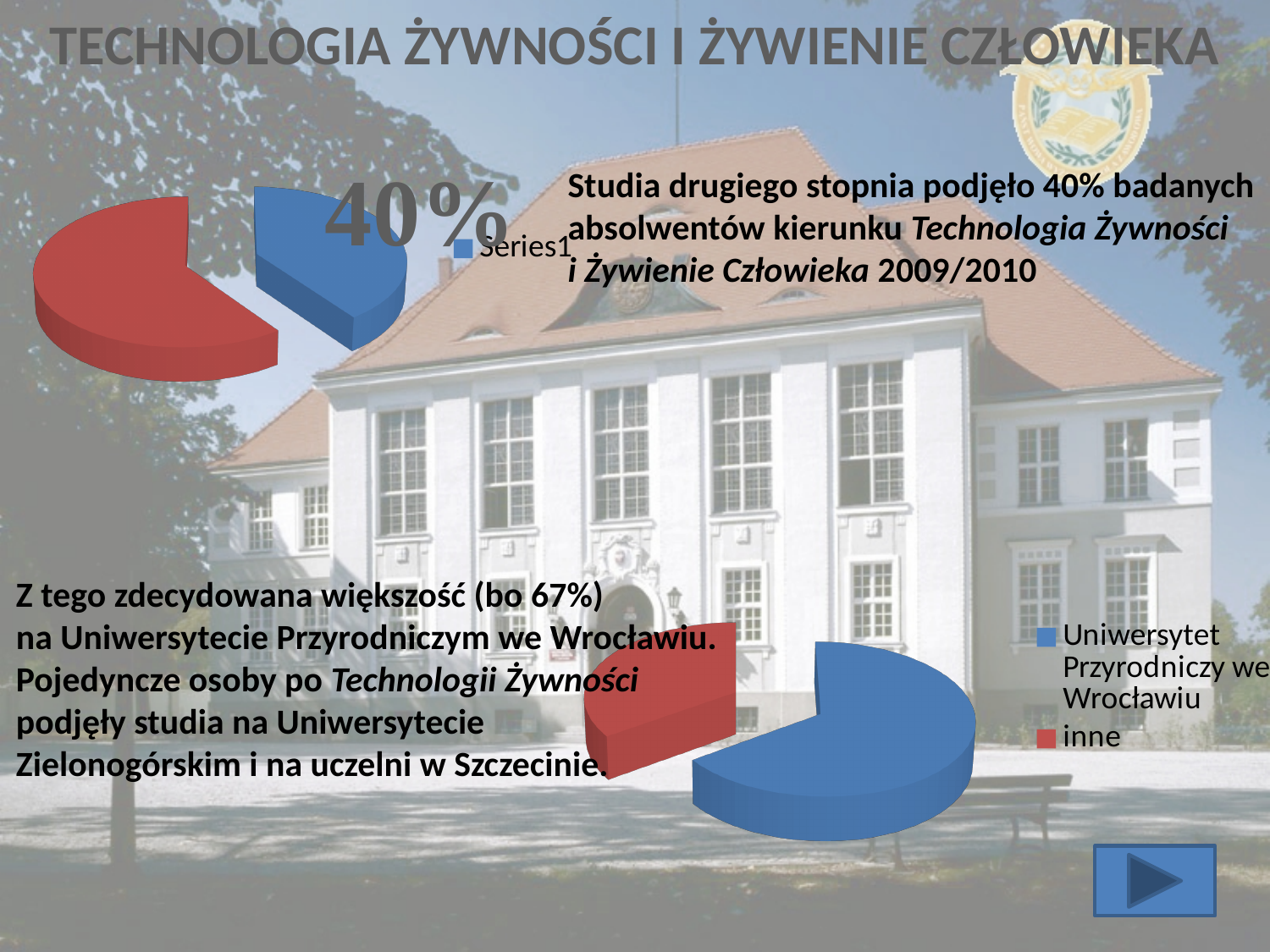
On the bottom-right pie chart, which category has the larger slice, 'Uniwersytet Przyrodniczy we Wrocławiu' or 'inne'? Uniwersytet Przyrodniczy we Wrocławiu What kind of chart is the bottom-right chart on the slide? pie chart What is the share of the blue slice in the top-left pie chart? 40% What is the share of the red slice in the top-left pie chart, given the blue slice is labelled 40%? 60% How many slices does the top-left pie chart have? 2 On the top-left pie chart, which slice is larger, the blue one or the red one? the red one On the bottom-right pie chart, which category has the smallest slice? inne What legend entry is shown next to the top-left pie chart? Series1 How many entries does the legend of the bottom-right pie chart list? 2 On the top-left pie chart, what value is printed as the data label on the blue slice? 40% On the bottom-right pie chart, what colour represents the category 'inne'? red What kind of chart is the top-left chart on the slide? pie chart